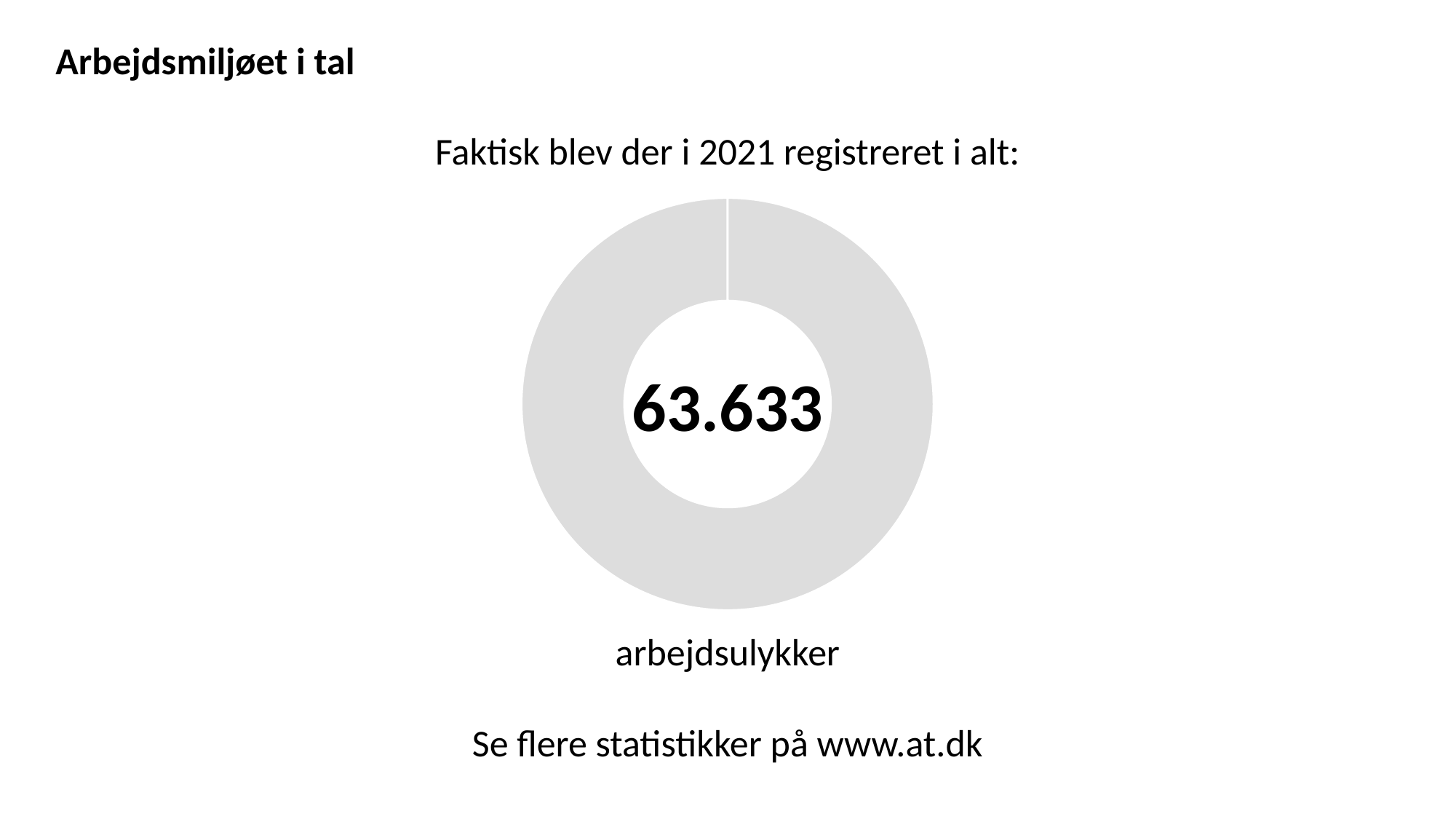
How many visible segments does the doughnut ring contain? 1 Which year does the figure in the doughnut chart refer to? 2021 What number is printed in the centre of the doughnut chart? 63.633 What kind of chart is shown on the slide? Doughnut chart Is the value shown in the doughnut chart greater or less than 60.000? greater What does the number 63.633 in the doughnut chart represent, according to the label below it? arbejdsulykker According to the slide, how many arbejdsulykker were registered in 2021? 63.633